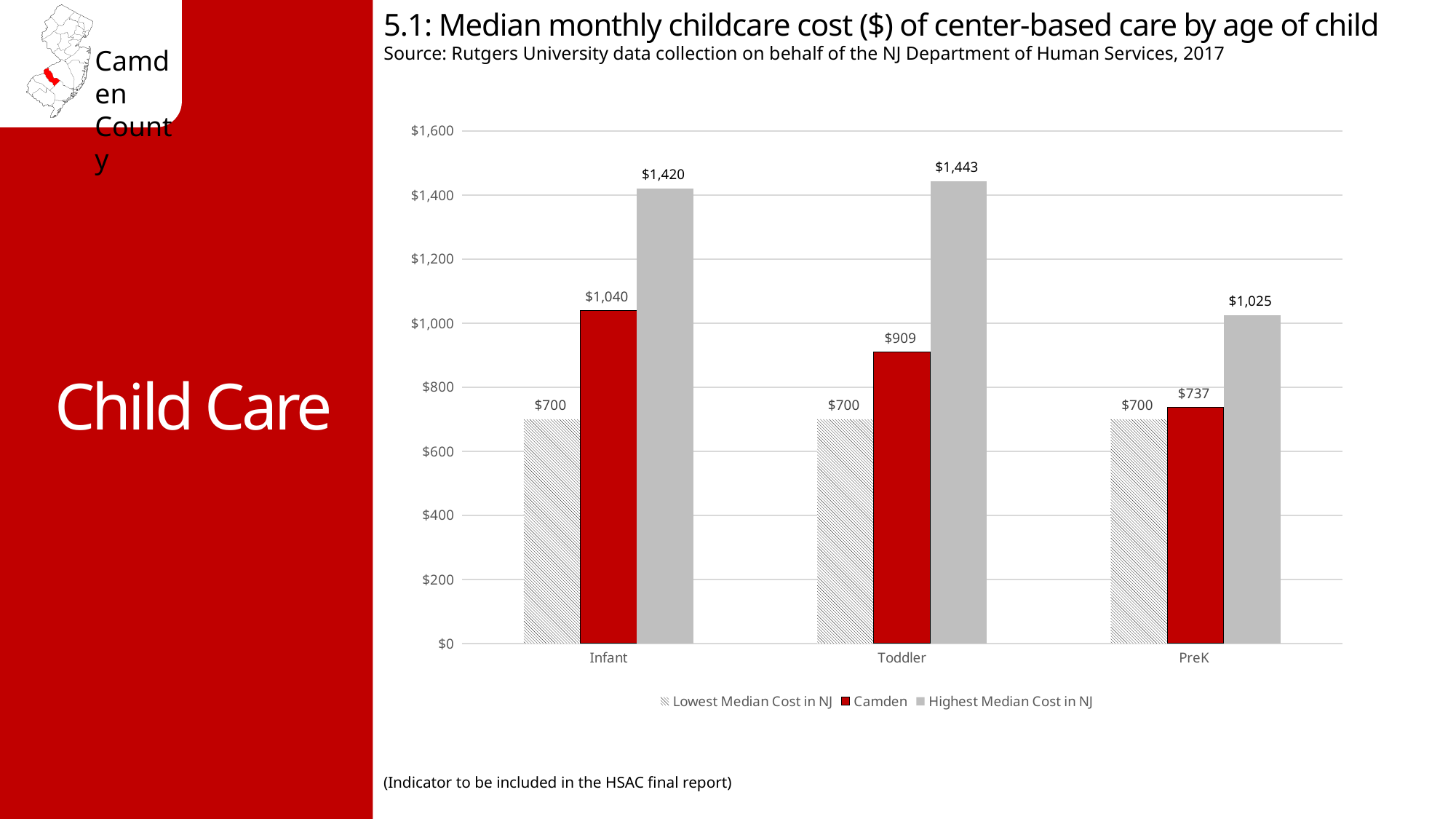
What is the Camden value for PreK? $737 Do the Camden values rise or fall from Infant to PreK? Fall What is the median monthly childcare cost for Camden for Infant care? $1,040 What is the difference between the Highest Median Cost in NJ and the Camden cost for Toddler care? $534 How many series does the legend list? 3 Which age group has the lowest Highest Median Cost in NJ? PreK What kind of chart is shown on the slide? Bar chart How many age groups are shown on the x axis? 3 Which age group has the highest Camden median monthly cost? Infant Which is larger, the Camden cost for Toddler or the Camden cost for PreK? Toddler What is the Highest Median Cost in NJ for Toddler care? $1,443 What is the difference between the Camden cost and the Lowest Median Cost in NJ for Infant care? $340